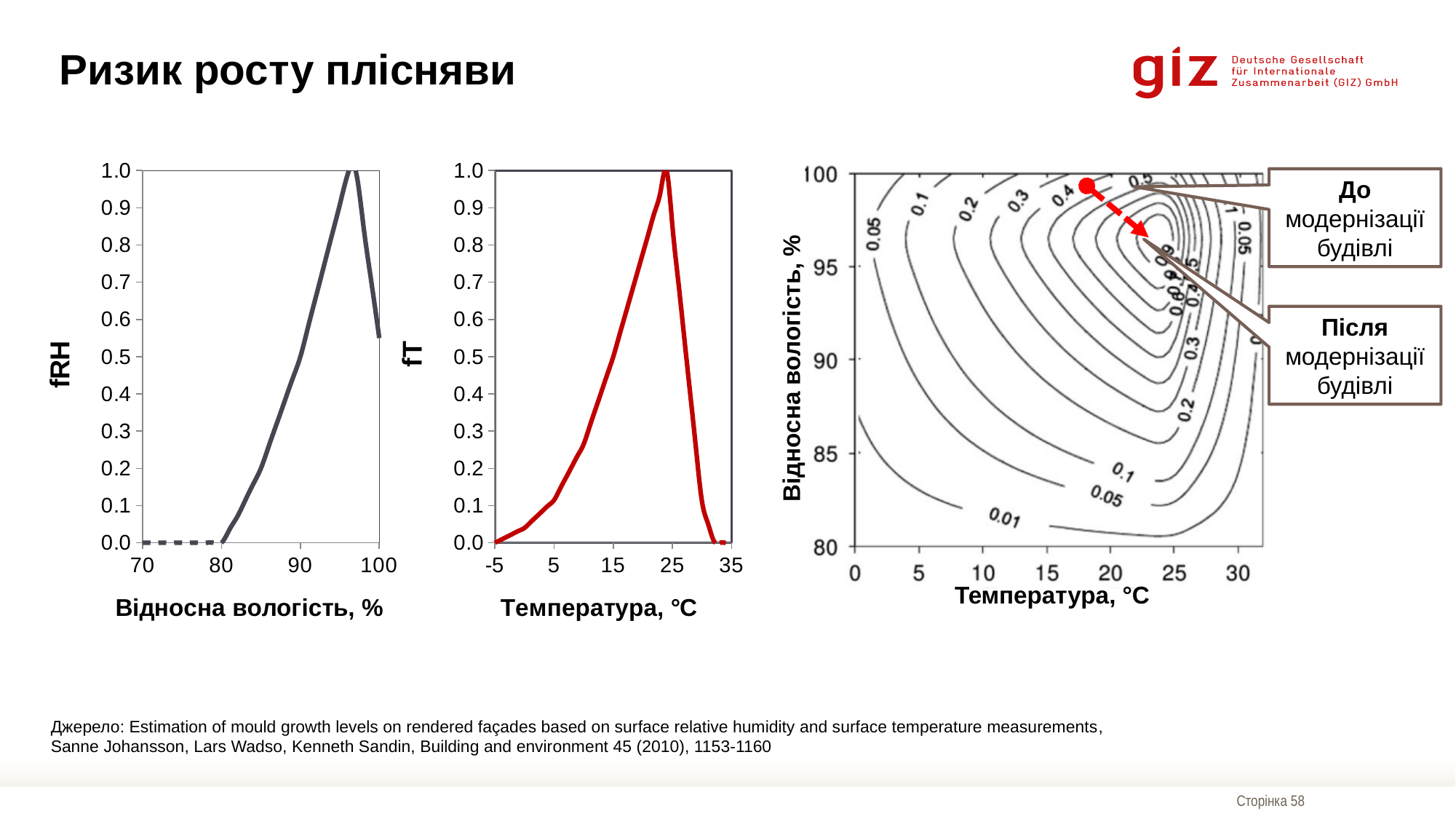
What kind of chart is the middle chart (fT vs temperature)? line chart On the left chart (fRH), what is the maximum value reached by the line? 1.0 On the middle chart (fT), is the value at a temperature of 5 °C greater or less than 0.5? less What is the x-axis label of the right (contour) chart? Температура, °C On the left chart (fRH), what is the value of fRH at a relative humidity of 80%? 0.0 On the middle chart (fT), is the value at a temperature of 25 °C greater or less than 0.5? greater On the left chart (fRH), does the line rise or fall between 80% and 95% relative humidity? rise On the left chart (fRH), is the value at a relative humidity of 85% greater or less than 0.5? less What kind of chart is the left chart (fRH vs relative humidity)? line chart On the middle chart (fT), what is the maximum value reached by the line? 1.0 On the middle chart (fT), does the line rise or fall between 25 °C and 35 °C? fall